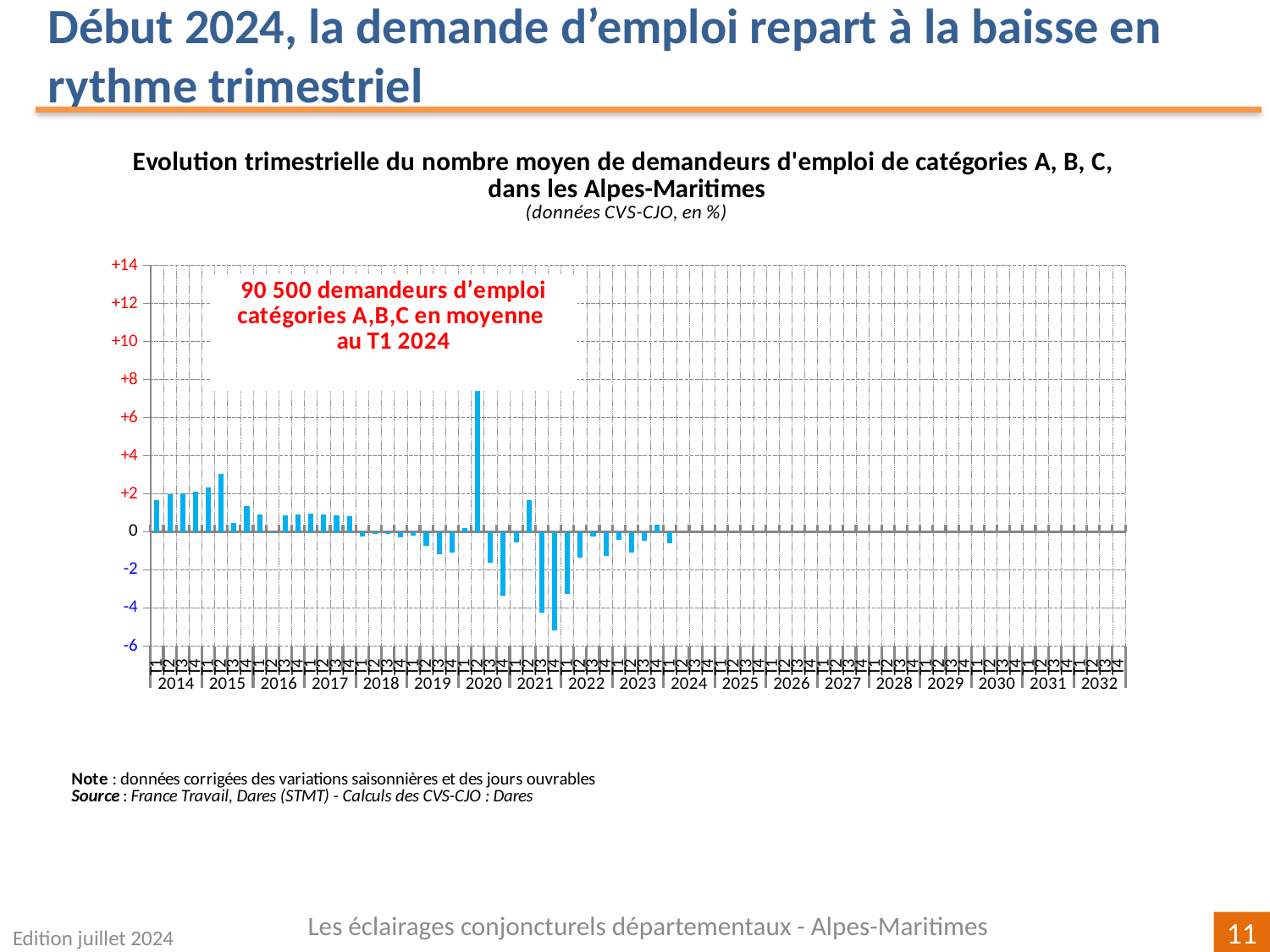
Is the value of the tallest bar in 2020 greater or less than +6? greater Do the bar values generally rise or fall from 2014 to 2019? fall Which is larger, the tallest bar in 2015 or the tallest bar in 2014? the tallest bar in 2015 In which year does the chart's highest bar occur? 2020 In what unit are the chart's data expressed, according to the subtitle? en % Is the value of the tallest bar in 2015 greater or less than +2? greater Is the value of the single bar shown for 2024 greater or less than 0? less How many year labels appear on the x axis of the chart? 19 What kind of chart is shown on the slide? bar chart According to the annotation on the chart, how many demandeurs d'emploi catégories A,B,C were there on average in T1 2024? 90 500 In which year does the chart's lowest bar occur? 2021